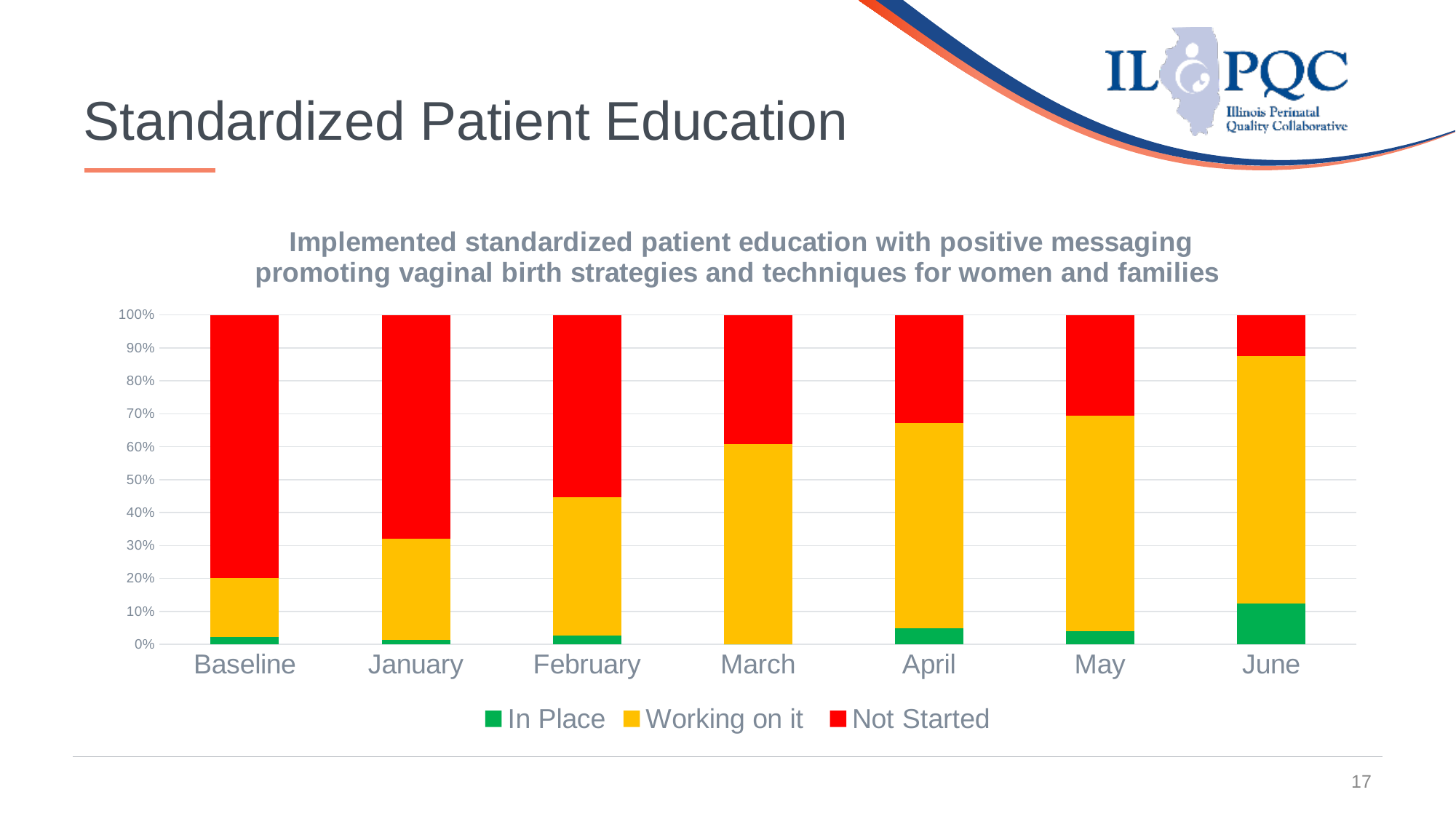
What kind of chart is shown on the slide? Stacked bar chart Does the 'Not Started' share rise or fall from Baseline to June? Fall Which category has the largest 'Not Started' segment? Baseline Which category has the smallest 'Not Started' segment? June How many series does the chart's legend list? 3 What colour represents the 'Not Started' series in the chart? Red Is the 'Not Started' share for Baseline greater or less than 70%? greater How many categories are shown along the x axis of the chart? 7 Is the 'In Place' share for June greater or less than 10%? greater Is the 'Not Started' share for June greater or less than 20%? less Which category has the largest 'In Place' segment? June Which has a larger 'Not Started' share, January or February? January